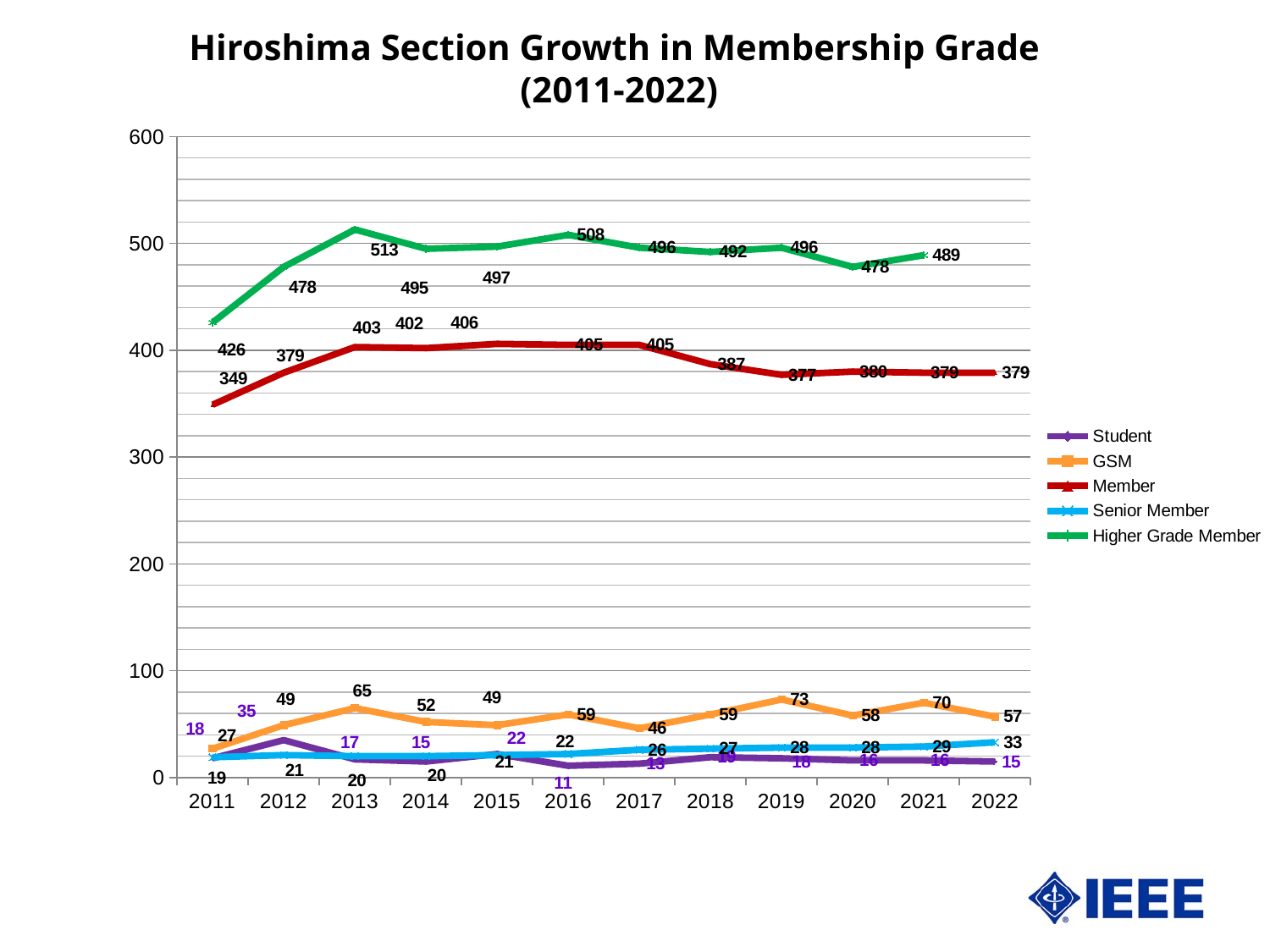
What is the Member value in 2011? 349 What is the difference between the Member value in 2013 and in 2011? 54 Does the Senior Member series generally rise or fall from 2011 to 2022? rise In which year is the Member value lowest? 2011 What is the GSM value in 2019? 73 How many series does the legend list? 5 Which year has the larger GSM value, 2013 or 2017? 2013 How many years are plotted along the x axis? 12 What is the Senior Member value in 2022? 33 In which year is the Higher Grade Member value highest? 2013 What kind of chart is shown on the slide? line chart What is the Higher Grade Member value in 2020? 478